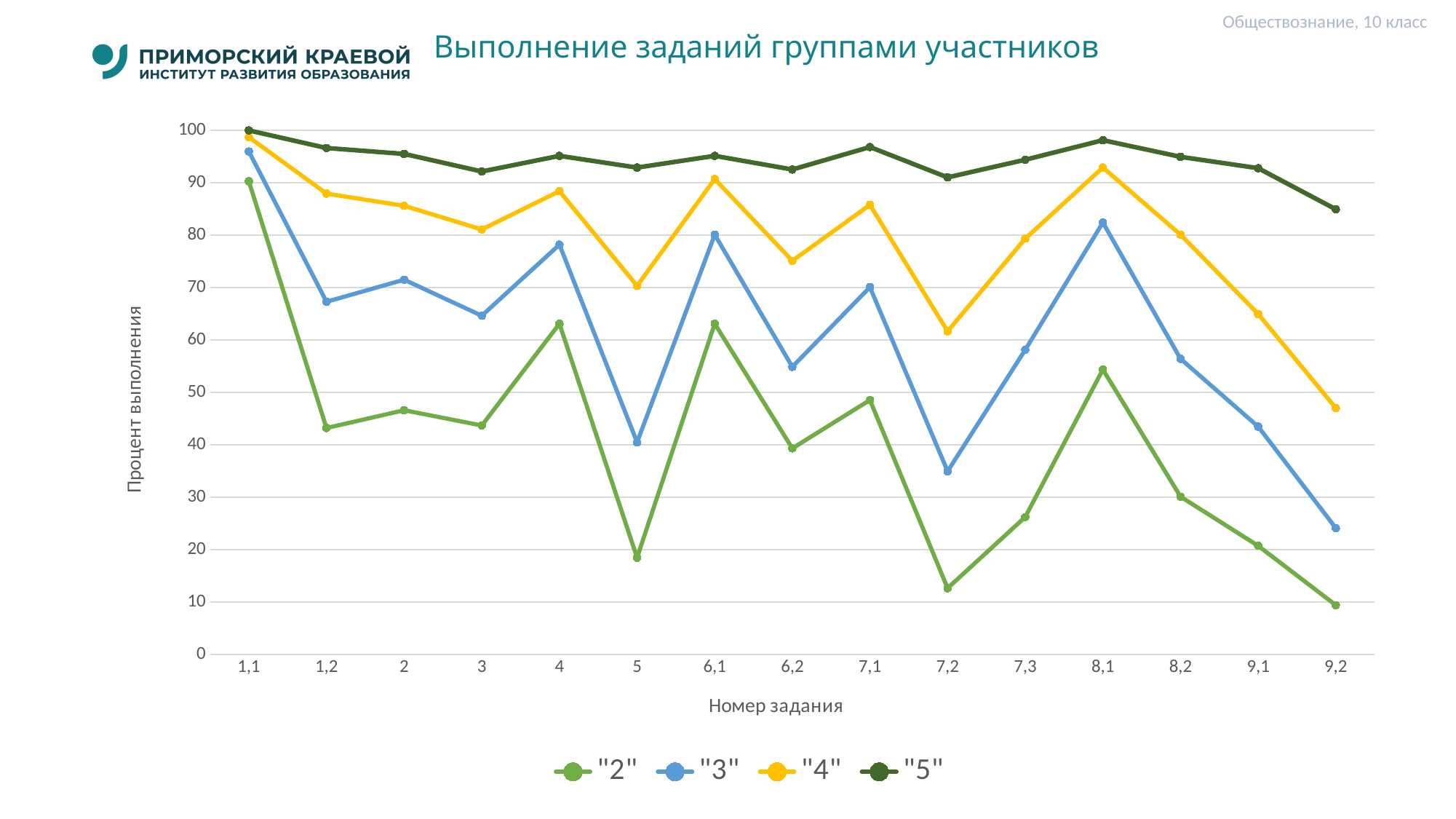
Is the value for series "4" at task 7,2 greater or less than 70? less Is the value for series "5" at task 9,2 greater or less than 90? less Do the values for series "2" rise or fall from task 8,1 to task 9,2? fall How many series does the legend list? 4 At task 5, which series has the larger value, "3" or "4"? "4" What kind of chart is shown on the slide? line chart Is the value for series "2" at task 5 greater or less than 20? less How many task numbers are shown along the x axis? 15 At which task number does series "3" reach its highest value? 1,1 Which series has the highest value at task 9,2? "5"